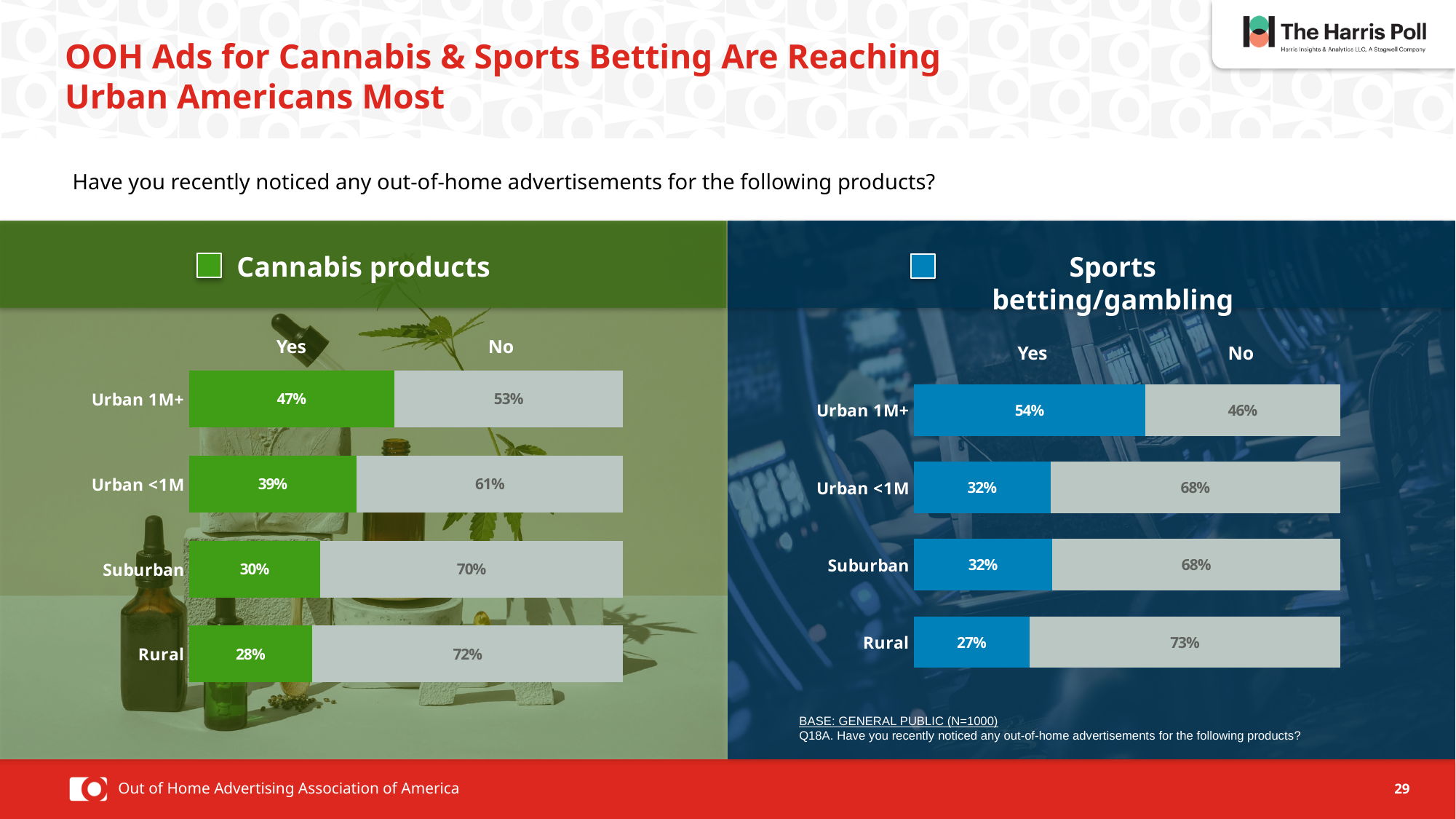
What colour represents the Yes responses in the Sports betting/gambling chart? Blue In the Sports betting/gambling chart, which category has the lowest Yes percentage? Rural What type of chart is used for the Sports betting/gambling data? Bar chart In the Sports betting/gambling chart, what is the difference between the Yes percentages for Urban 1M+ and Urban <1M? 22 percentage points In the Cannabis products chart, what percentage of Urban 1M+ respondents answered Yes? 47% How many categories are shown in the Cannabis products chart? 4 In the Cannabis products chart, what is the difference between the Yes percentages for Urban 1M+ and Rural? 19 percentage points In the Sports betting/gambling chart, what percentage of Rural respondents answered No? 73% How many series (Yes and No) does each chart show? 2 In the Cannabis products chart, do the Yes percentages rise or fall going from Urban 1M+ down to Rural? Fall In the Cannabis products chart, which category has the highest Yes percentage? Urban 1M+ Is the Yes percentage for Suburban higher in the Cannabis products chart or the Sports betting/gambling chart? Sports betting/gambling